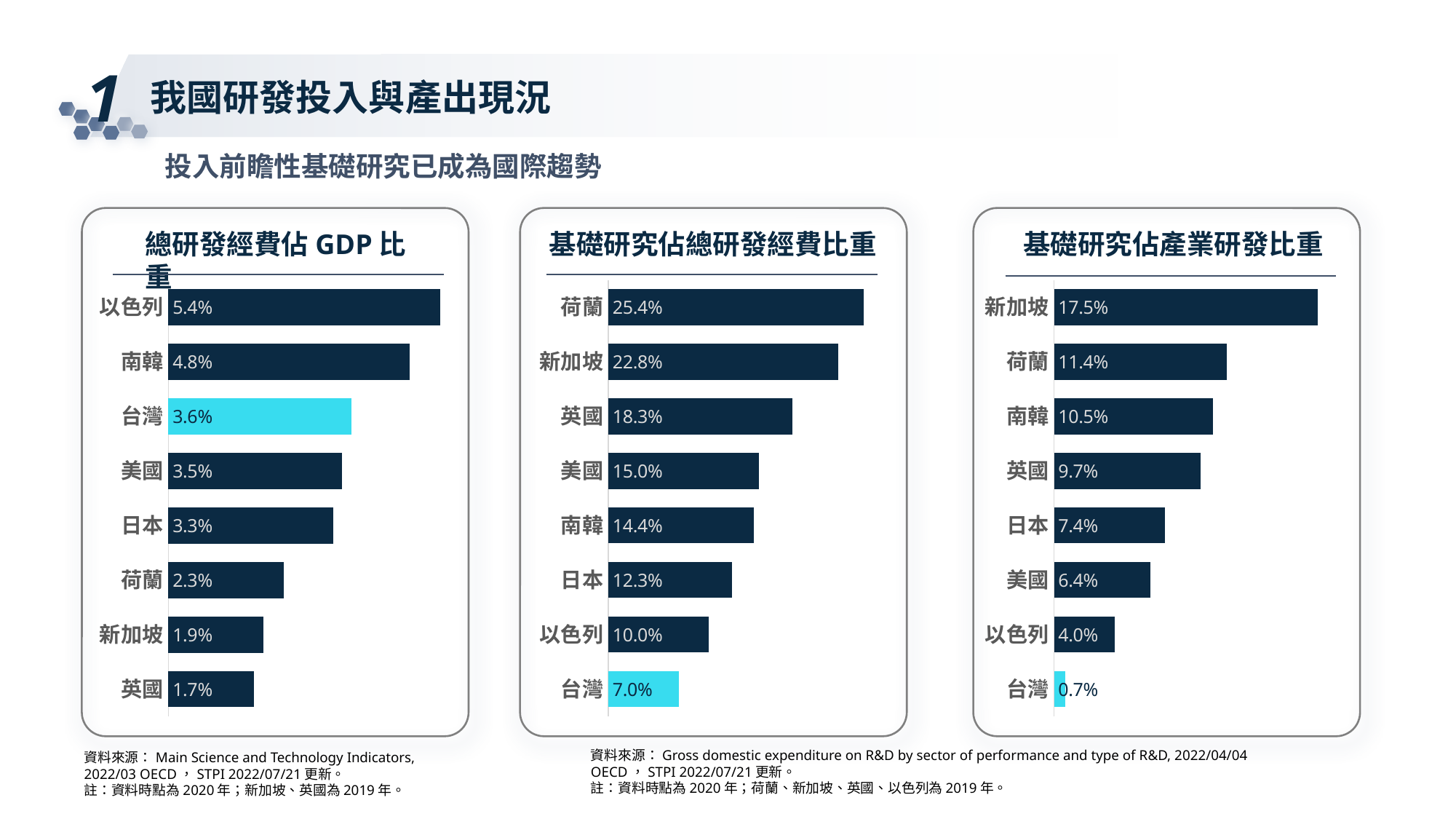
In the chart titled 總研發經費佔 GDP 比重, what is the value for 台灣? 3.6% In the chart titled 基礎研究佔總研發經費比重, which category has the lowest value? 台灣 What kind of chart is the chart titled 基礎研究佔產業研發比重? Bar chart In the chart titled 總研發經費佔 GDP 比重, which category has the highest value? 以色列 In the chart titled 總研發經費佔 GDP 比重, which category has the lowest value? 英國 In the chart titled 基礎研究佔總研發經費比重, which is larger, the value for 英國 or the value for 美國? 英國 In the chart titled 基礎研究佔產業研發比重, which category's bar is highlighted in a different colour (light blue)? 台灣 In the chart titled 基礎研究佔總研發經費比重, how many categories are shown? 8 In the chart titled 基礎研究佔產業研發比重, what is the value for 新加坡? 17.5% In the chart titled 基礎研究佔產業研發比重, what is the difference between the values for 荷蘭 and 南韓? 0.9% In the chart titled 基礎研究佔總研發經費比重, what is the value for 荷蘭? 25.4% In the chart titled 總研發經費佔 GDP 比重, what is the difference between the values for 以色列 and 南韓? 0.6%